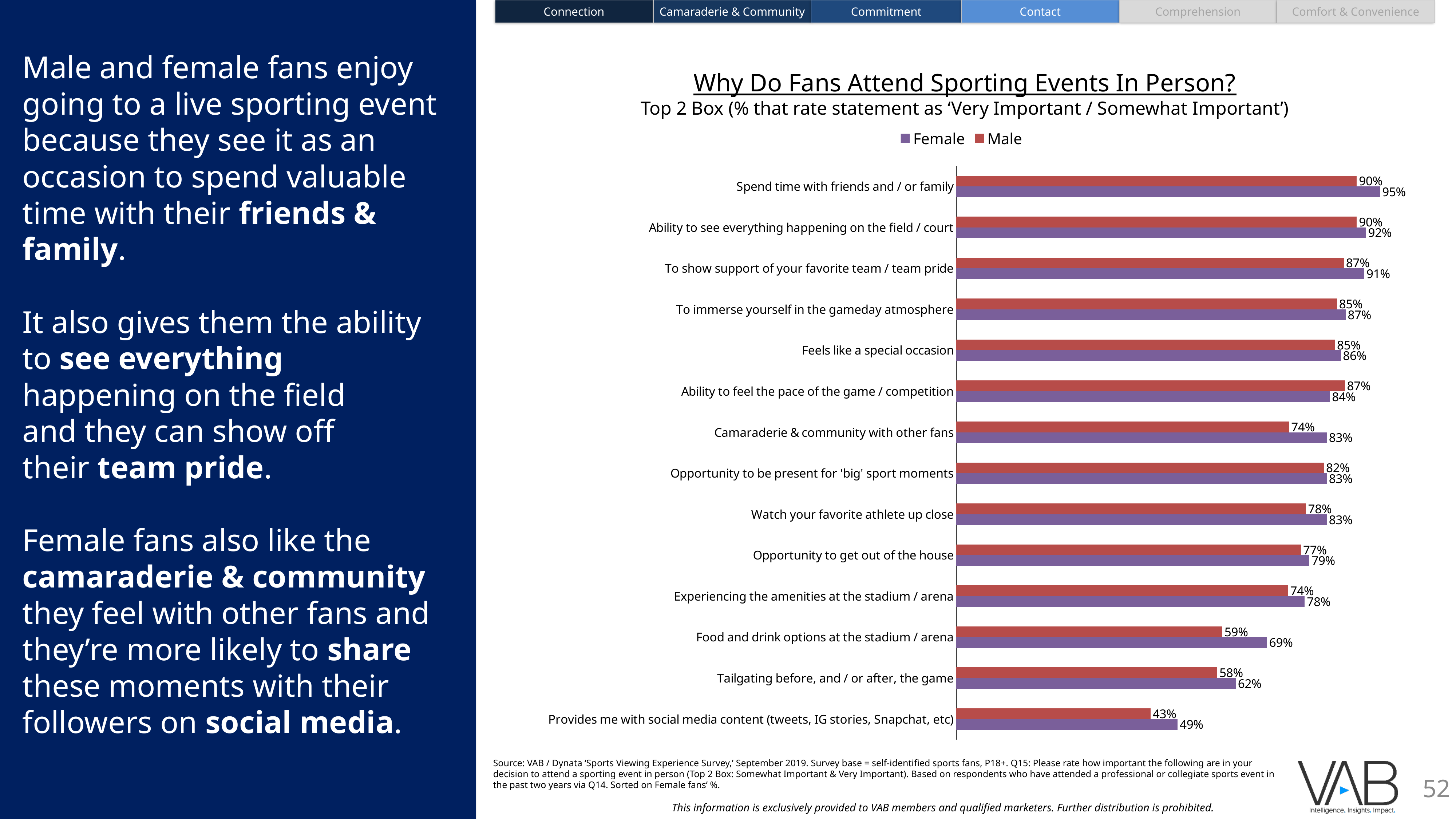
What is the difference between the Female and Male values for 'Camaraderie & community with other fans'? 9 percentage points What percentage of female fans rate 'Spend time with friends and / or family' as important? 95% What is the Male value for 'Food and drink options at the stadium / arena'? 59% What is the difference between the Female and Male values for 'Food and drink options at the stadium / arena'? 10 percentage points How many categories (reasons) are shown in the chart? 14 Which category has the highest Female value? Spend time with friends and / or family What percentage of male fans rate 'Camaraderie & community with other fans' as important? 74% Which colour represents the Female series in the chart? Purple What type of chart is shown on the slide? Bar chart How many series does the legend list? 2 For 'Ability to feel the pace of the game / competition', which is larger, the Male or Female value? Male Which category has the lowest Female value? Provides me with social media content (tweets, IG stories, Snapchat, etc)